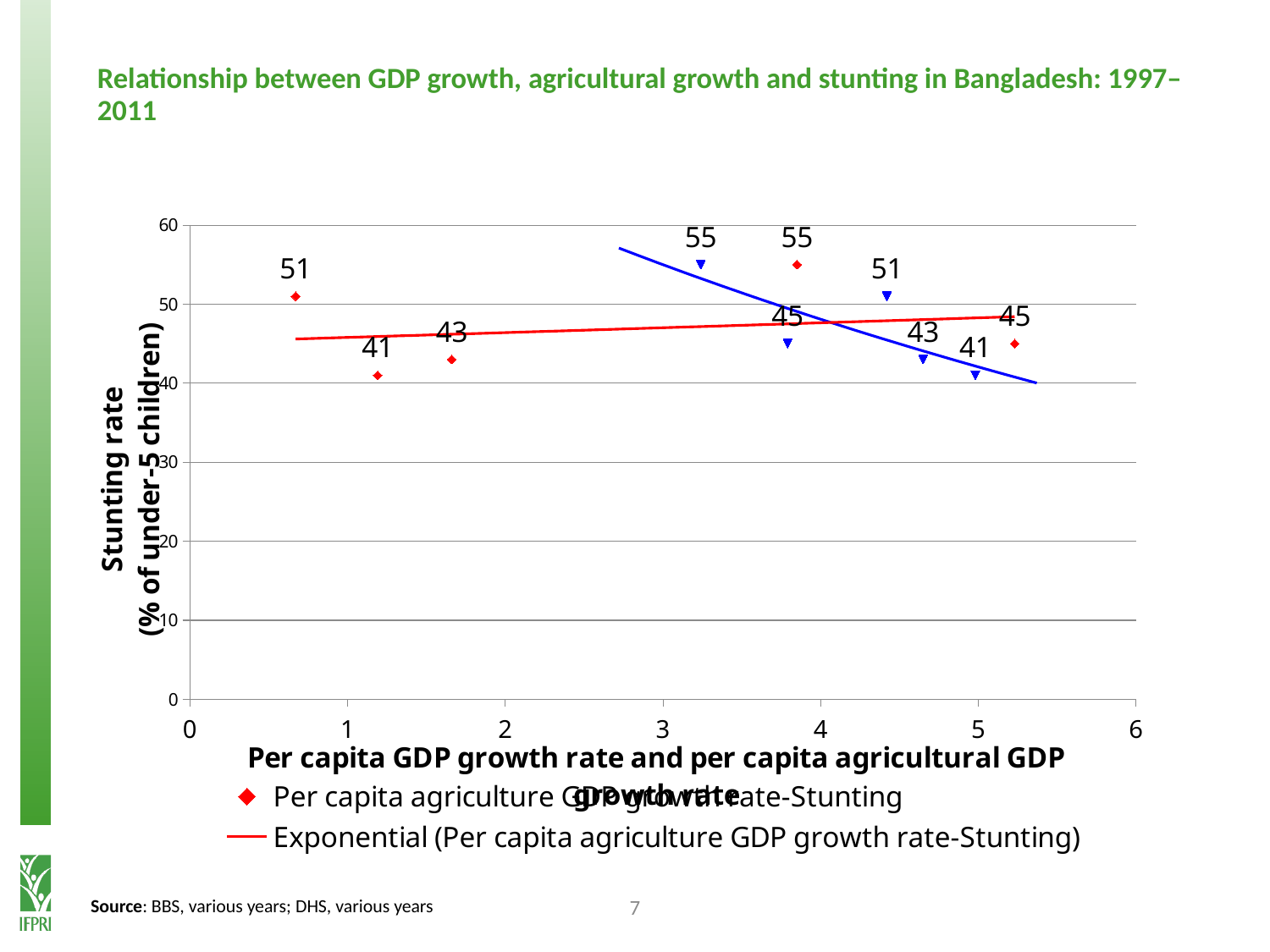
What is the data label on the rightmost blue triangle point? 41 Does the blue trend line rise or fall as the growth rate increases along the x axis? fall What is the label of the y axis? Stunting rate (% of under-5 children) How many blue triangle data points are plotted on the chart? 5 What is the data label on the leftmost red diamond point? 51 What is the lowest stunting rate labelled among the red diamond points? 41 What is the data label on the leftmost blue triangle point? 55 What is the difference between the highest and lowest labelled values among the blue triangle points? 14 What is the highest stunting rate labelled among the red diamond points? 55 What kind of chart is shown on the slide? scatter chart How many red diamond data points are plotted on the chart? 5 What is the data label on the rightmost red diamond point? 45